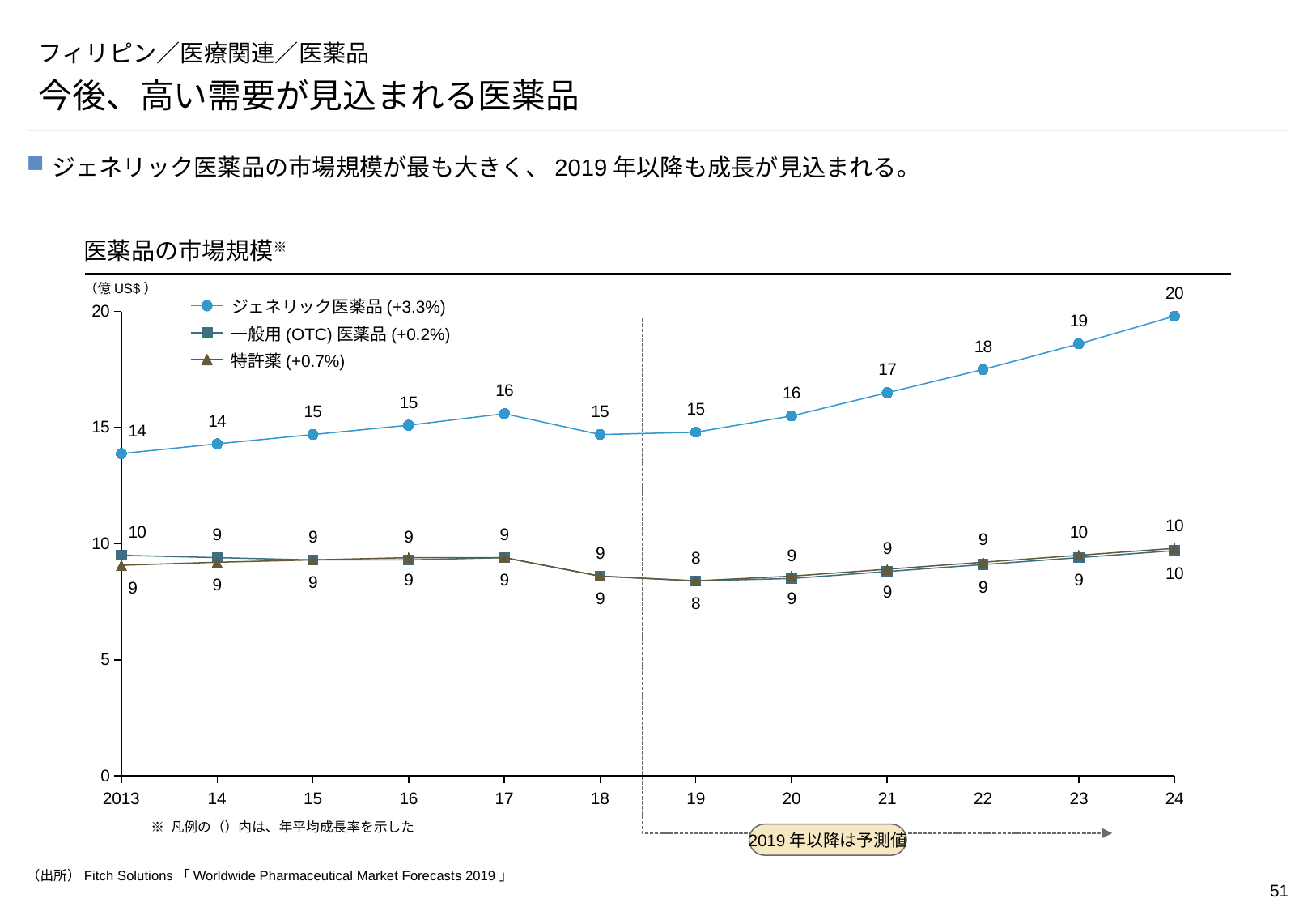
What is the value for ジェネリック医薬品 in 2017? 16 How many series does the legend list? 3 In which year is the value for ジェネリック医薬品 highest? 2024 What unit is shown on the vertical axis of the chart? 億US$ What is the value for 特許薬 in 2019? 8 What is the value for ジェネリック医薬品 in 2024? 20 Does the value for ジェネリック医薬品 rise or fall from 2019 to 2024? rise What is the value for 一般用 (OTC) 医薬品 in 2013? 10 What is the difference between the ジェネリック医薬品 values in 2024 and 2013? 6 Which series has the larger value in 2021, ジェネリック医薬品 or 特許薬? ジェネリック医薬品 What is the value for ジェネリック医薬品 in 2013? 14 What type of chart is shown on the slide? line chart